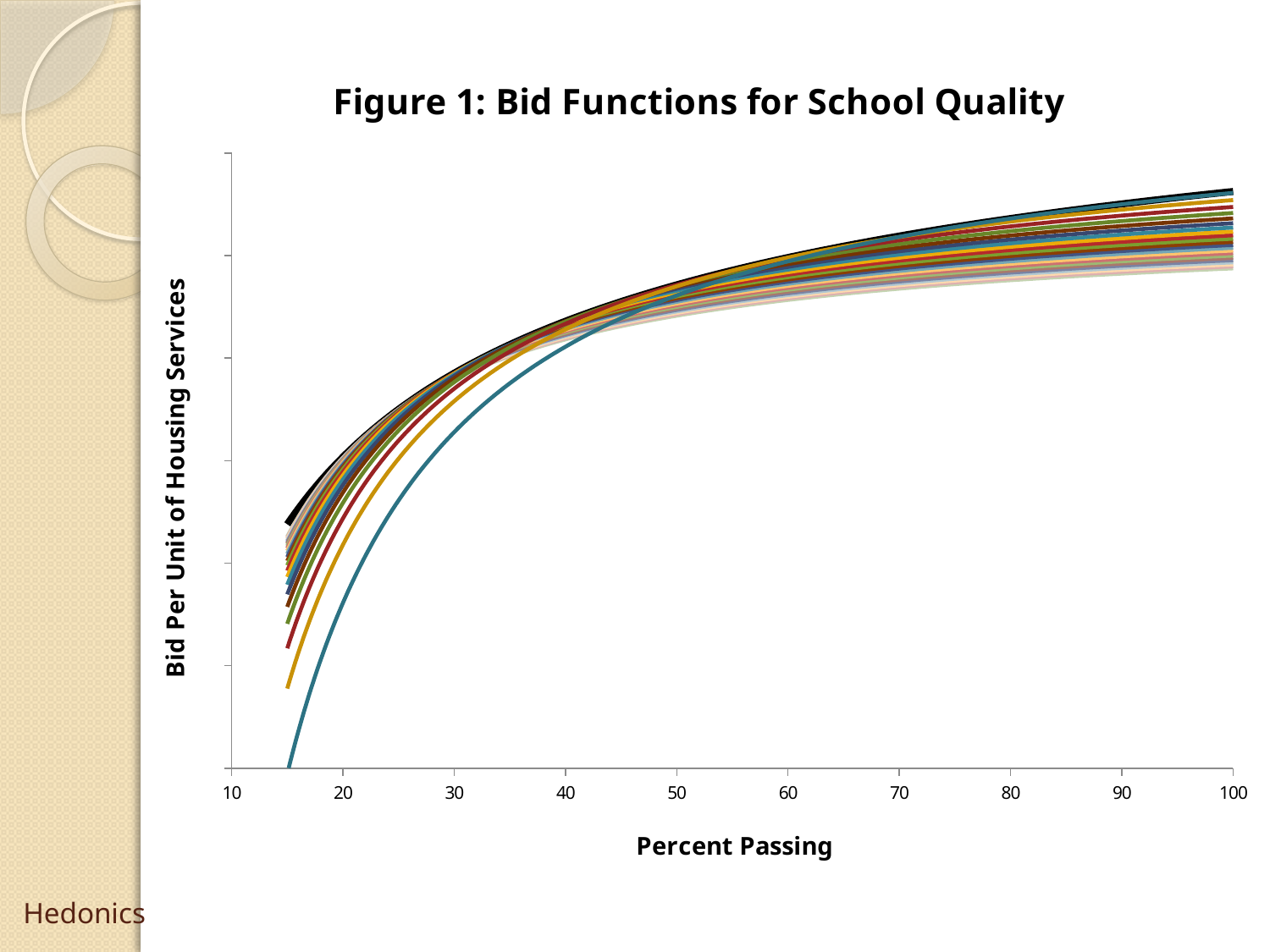
Do the curves rise more steeply at low or at high values of Percent Passing? Low Is the value of the curves at Percent Passing 100 greater or less than their value at Percent Passing 20? greater What kind of chart is shown on the slide? Line chart As Percent Passing increases along the x axis, do the bid curves rise or fall? Rise What is the title of the chart? Figure 1: Bid Functions for School Quality What is the label of the x axis? Percent Passing What is the largest value labelled on the x axis? 100 What is the smallest value labelled on the x axis? 10